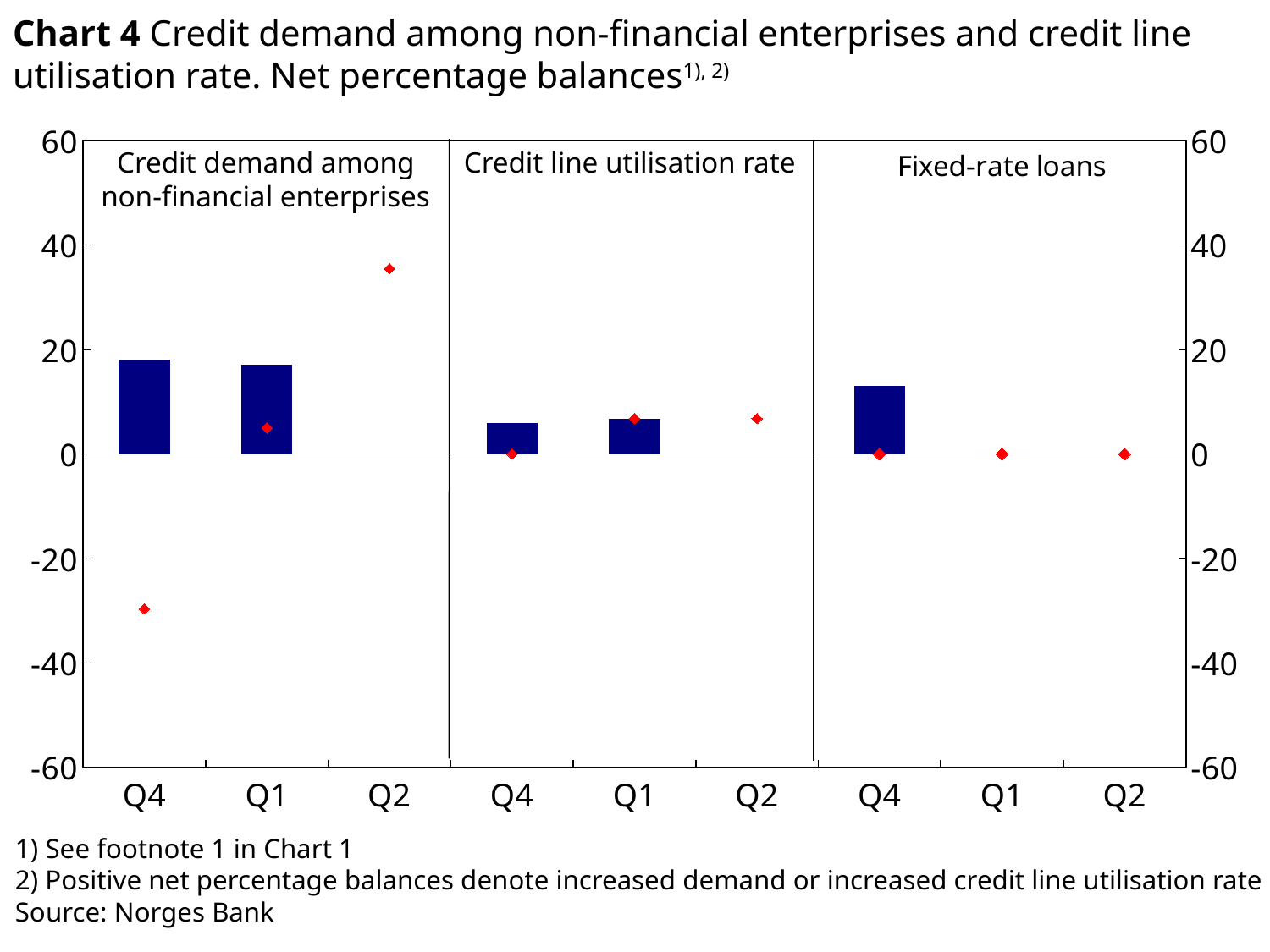
In the 'Credit line utilisation rate' panel, is the Q4 bar greater or less than 20? less What is the title of the middle panel in Chart 4? Credit line utilisation rate What is the source given for Chart 4? Norges Bank How many quarters are labelled on the x axis of each panel in Chart 4? 3 Which is larger: the Q4 bar in the 'Credit demand among non-financial enterprises' panel or the Q4 bar in the 'Credit line utilisation rate' panel? Credit demand among non-financial enterprises How many panels does Chart 4 have? 3 What kind of chart is Chart 4? combination bar and marker (line) chart In the 'Credit demand among non-financial enterprises' panel, is the red marker for Q2 greater or less than 20? greater Which panel has the highest Q4 bar in Chart 4? Credit demand among non-financial enterprises Which panel has the lowest Q4 bar in Chart 4? Credit line utilisation rate In the 'Fixed-rate loans' panel, is the Q4 bar greater or less than 0? greater